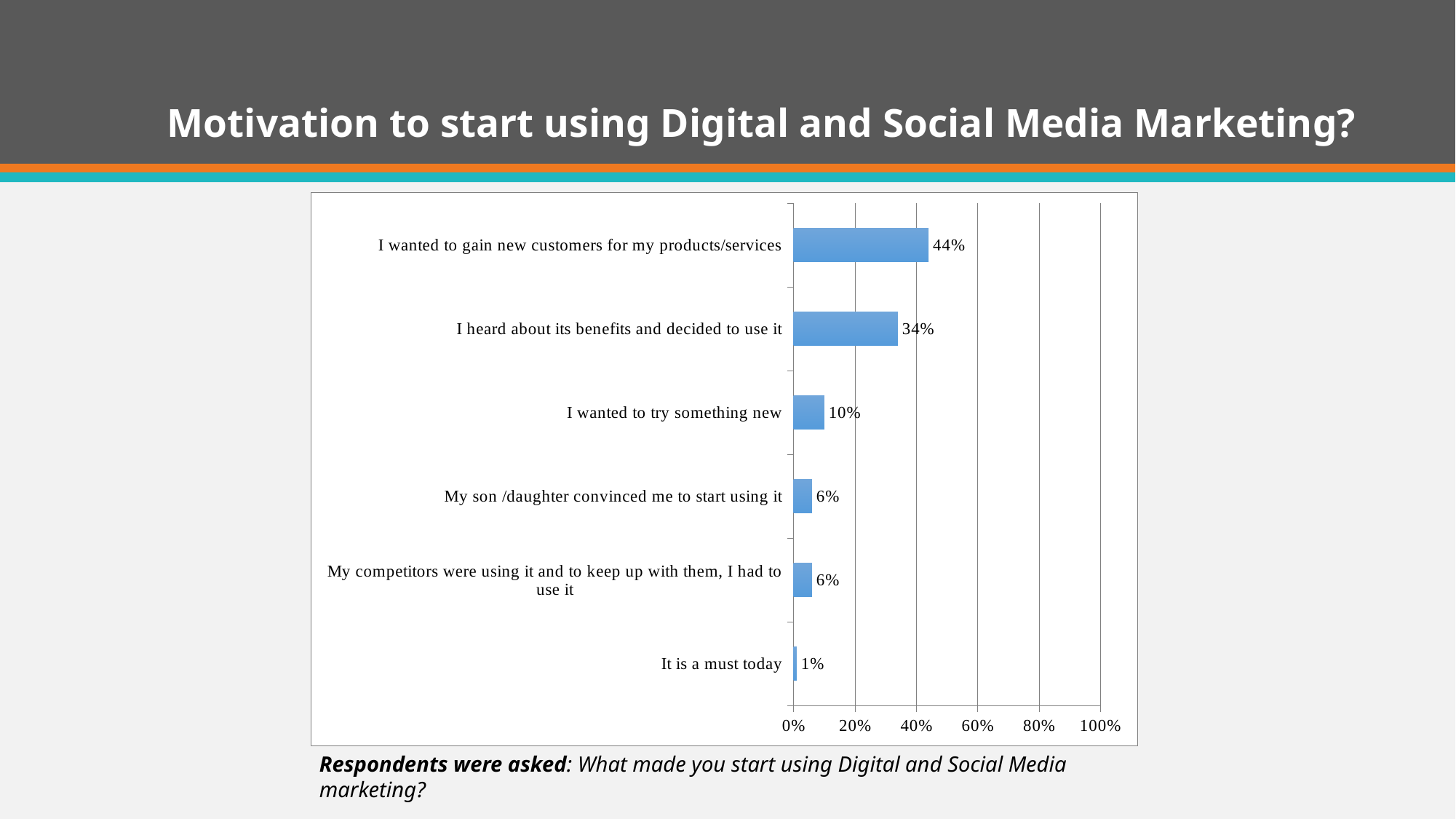
Is the value for "I wanted to gain new customers for my products/services" greater or less than 40%? greater What type of chart is shown on the slide? Bar chart What is the difference between "I wanted to gain new customers for my products/services" and "I heard about its benefits and decided to use it"? 10% What percentage of respondents said "I wanted to try something new"? 10% What is the value for "It is a must today"? 1% Which motivation has the lowest percentage? It is a must today What is the maximum value shown on the horizontal axis? 100% Which motivation has the highest percentage? I wanted to gain new customers for my products/services Which is larger: "I wanted to try something new" or "My son /daughter convinced me to start using it"? I wanted to try something new What percentage of respondents said they wanted to gain new customers for their products/services? 44% How many motivation categories are shown in the chart? 6 What is the value for "I heard about its benefits and decided to use it"? 34%